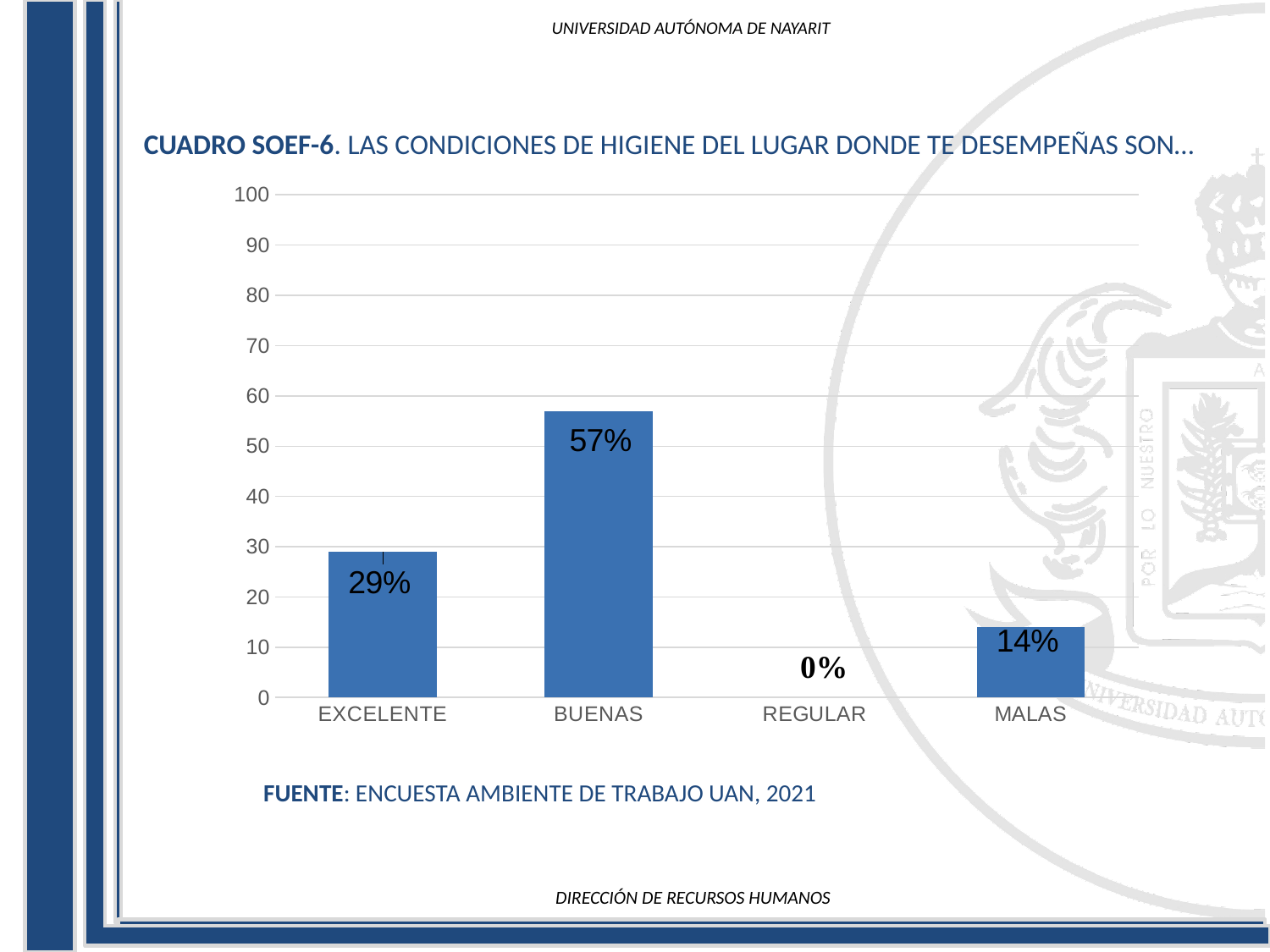
What is the difference between the values for BUENAS and EXCELENTE? 28% What is the value for REGULAR? 0% What is the value for BUENAS? 57% What kind of chart is shown on the slide? bar chart What is the difference between the values for EXCELENTE and MALAS? 15% What is the value for EXCELENTE? 29% Which category has the highest value? BUENAS Which is larger, the value for EXCELENTE or the value for MALAS? EXCELENTE Which category has the lowest value? REGULAR What is the value for MALAS? 14% How many categories are shown on the x axis? 4 Is the value for BUENAS greater or less than 50? greater